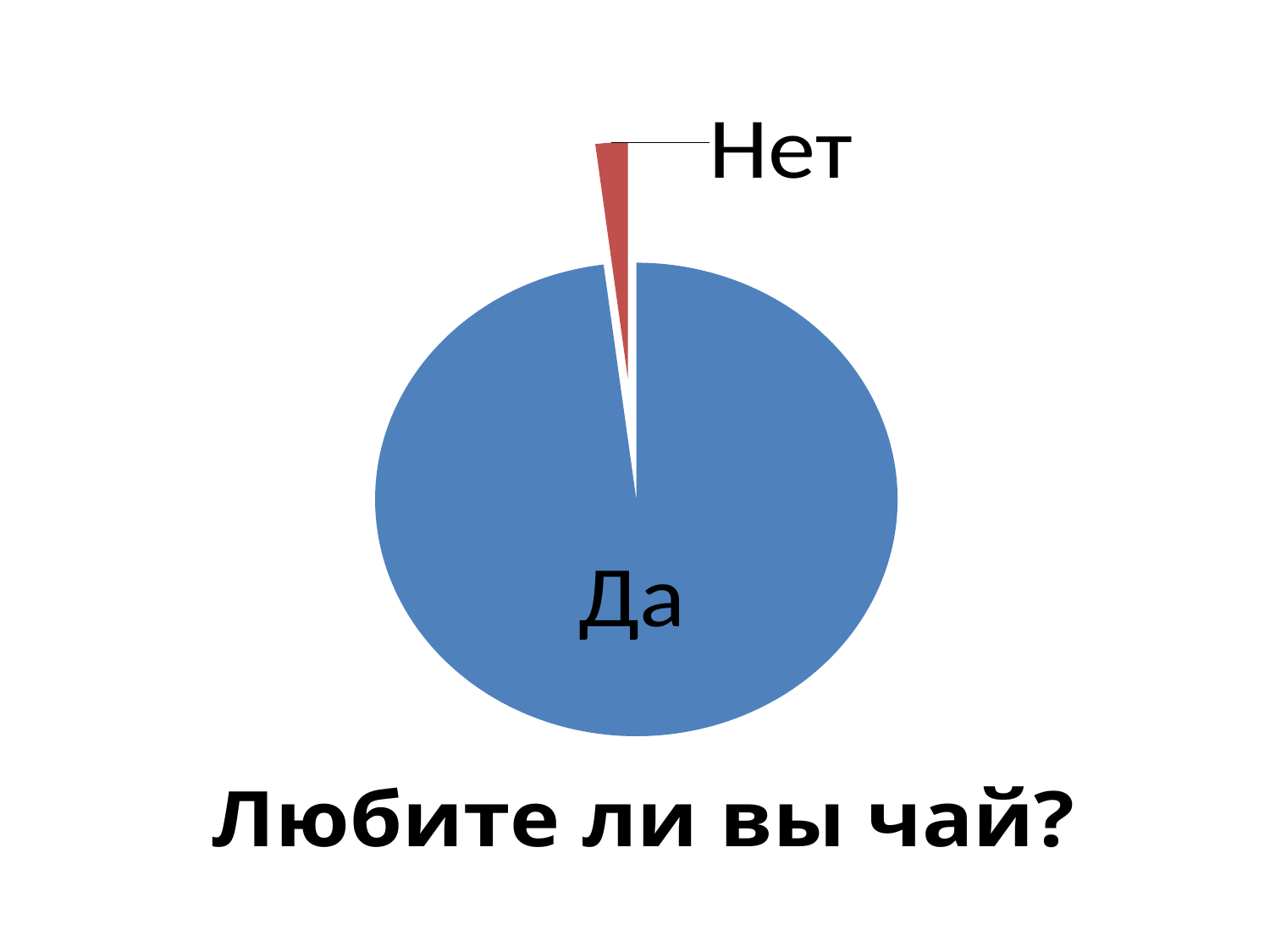
How many slices does the pie chart have? 2 What colour is the Нет slice? red Which slice of the pie chart is the largest? Да Which slice is larger, Да or Нет? Да Which slice of the pie chart is the smallest? Нет What kind of chart is shown on the slide? pie chart What is the title of the chart? Любите ли вы чай?